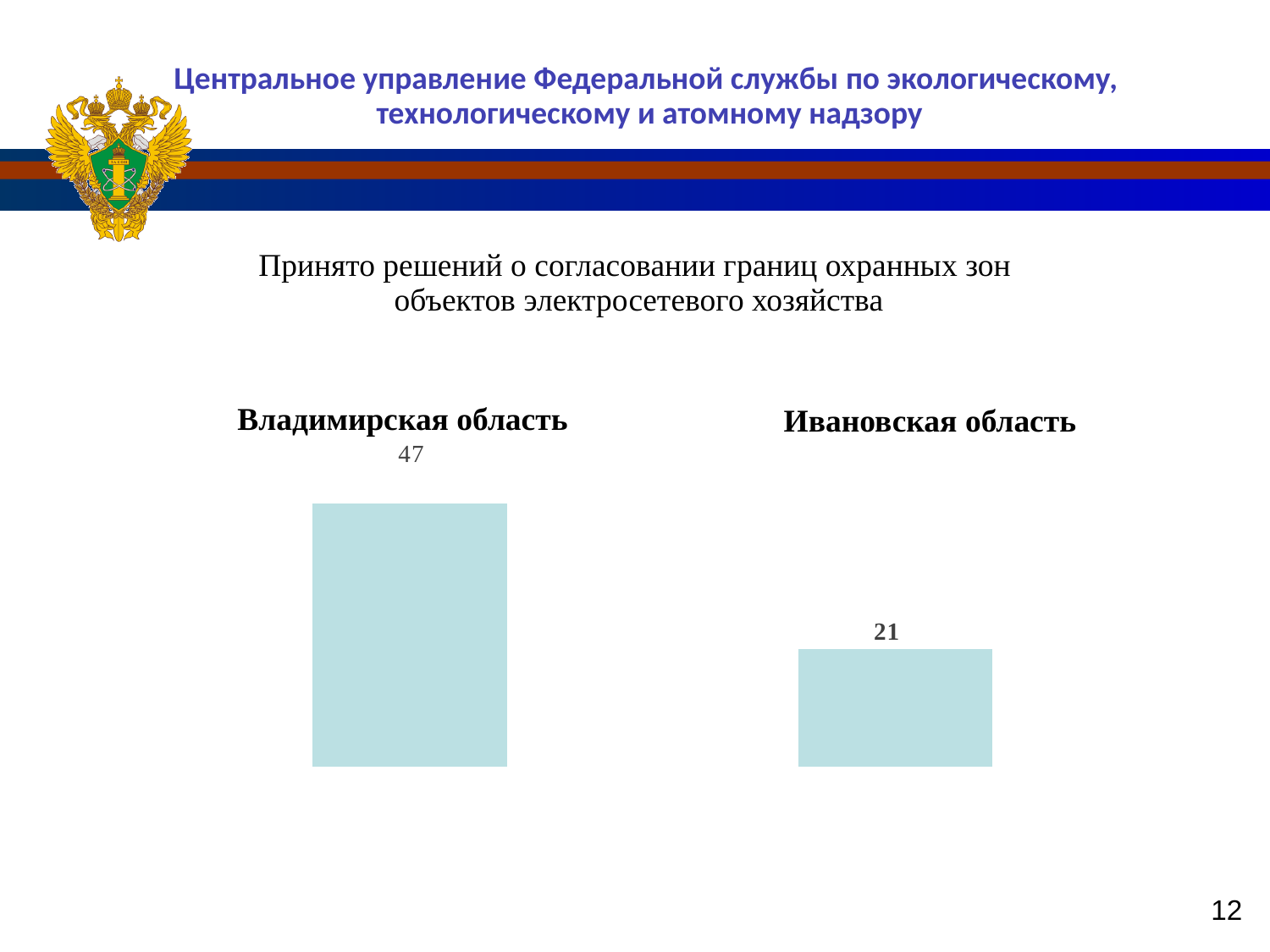
What is the title of the chart on the left side of the slide? Владимирская область How many bars are plotted on the chart titled "Ивановская область"? 1 On the chart titled "Владимирская область", what value is shown on the bar? 47 Comparing the two charts, which region has the larger value: Владимирская область or Ивановская область? Владимирская область On the chart titled "Ивановская область", what value is shown on the bar? 21 Comparing the two charts, which region has the smaller value? Ивановская область What type of chart is used on the left chart titled "Владимирская область"? bar chart How many bars are plotted on the chart titled "Владимирская область"? 1 What is the difference between the value on the "Владимирская область" chart and the value on the "Ивановская область" chart? 26 What is the title of the chart on the right side of the slide? Ивановская область What is the total of the values shown on the two charts (Владимирская область and Ивановская область)? 68 What type of chart is used on the right chart titled "Ивановская область"? bar chart